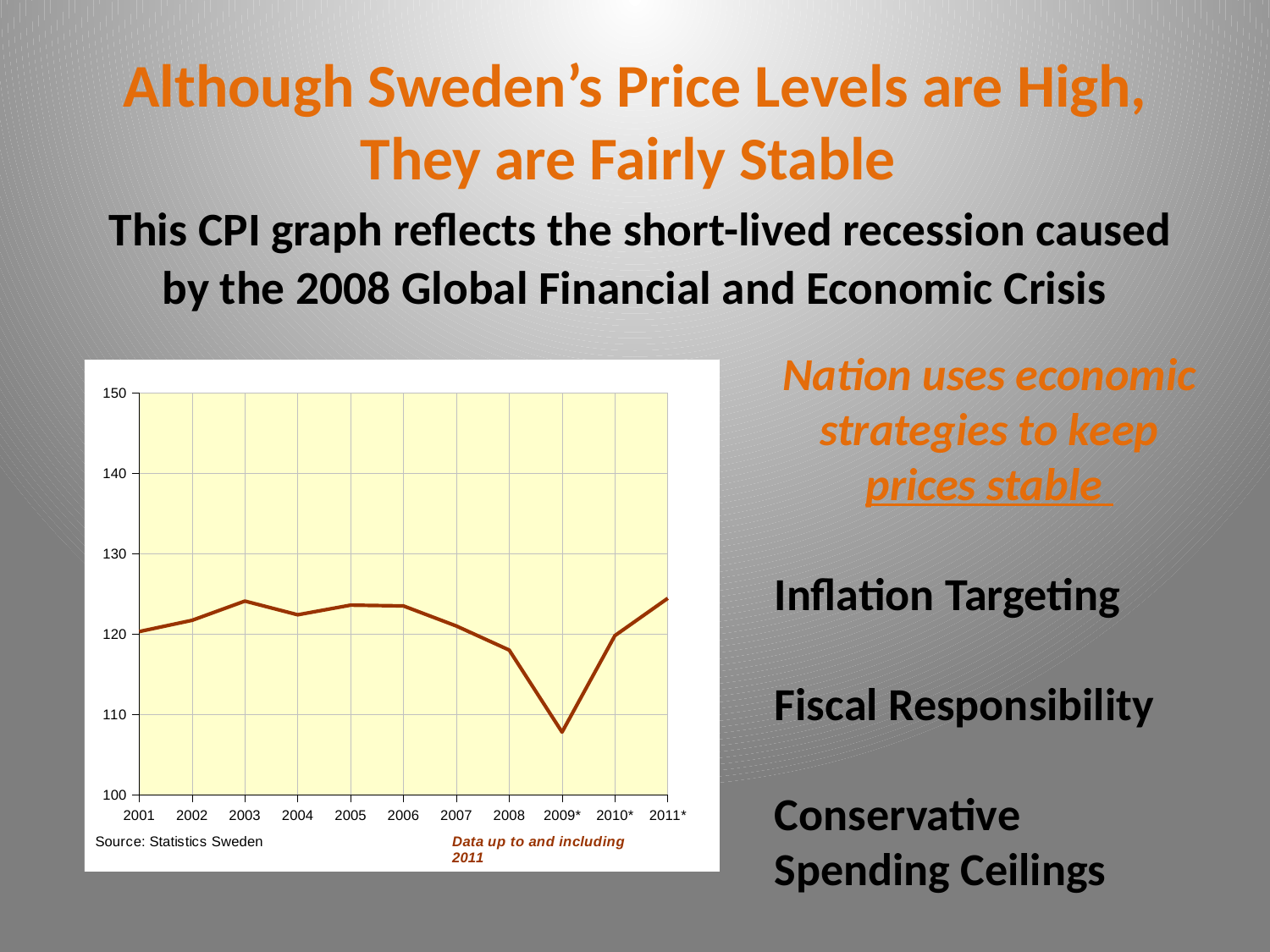
Which year has the lowest CPI value on the chart? 2009* What kind of chart is shown on the slide? line chart Does the CPI line rise or fall between 2006 and 2009*? fall How many years are plotted along the x axis of the chart? 11 Which year has the larger CPI value, 2005 or 2008? 2005 Does the CPI line rise or fall between 2009* and 2011*? rise Is the CPI value for 2005 greater or less than 130? less Which year has the larger CPI value, 2003 or 2009*? 2003 Is the CPI value for 2009* greater or less than 110? less Is the CPI value for 2003 greater or less than 120? greater What source is cited below the chart? Statistics Sweden